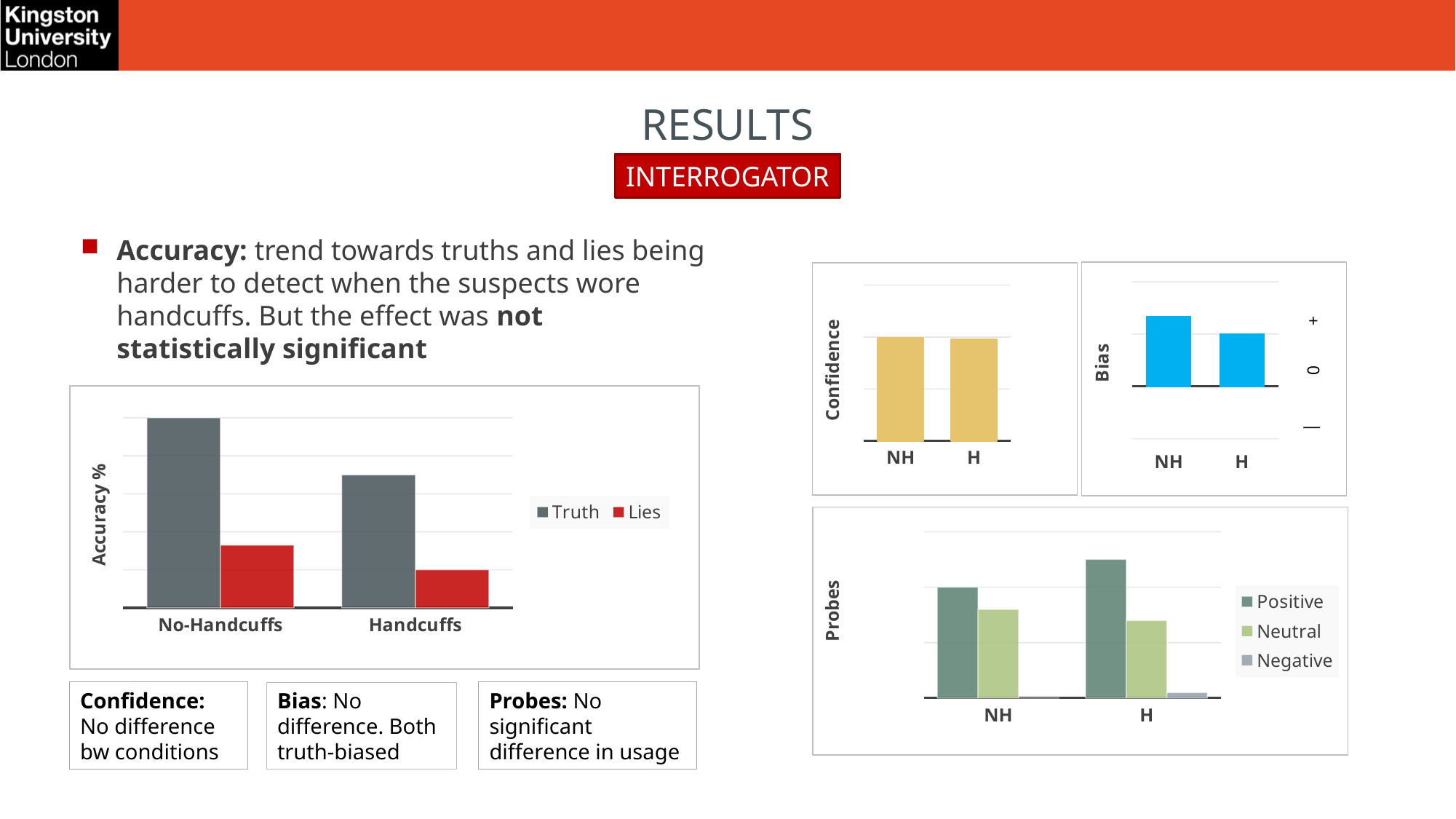
In the Accuracy % chart, which bar is the lowest overall? Lies for Handcuffs In the Bias chart, is the value for H greater or less than 0? greater In the Accuracy % chart, do the Lies values rise or fall from No-Handcuffs to Handcuffs? fall How many series does the legend of the Probes chart list? 3 In the Accuracy % chart, is the Truth value higher for No-Handcuffs or for Handcuffs? No-Handcuffs How many categories are shown on the x axis of the Confidence chart? 2 In the Probes chart, which series has the highest bar for H? Positive In the Bias chart, which category has the higher bar, NH or H? NH In the Accuracy % chart, how many series does the legend list? 2 What kind of chart is the Accuracy % chart on the left of the slide? bar chart In the Accuracy % chart, which series has the higher value for No-Handcuffs, Truth or Lies? Truth